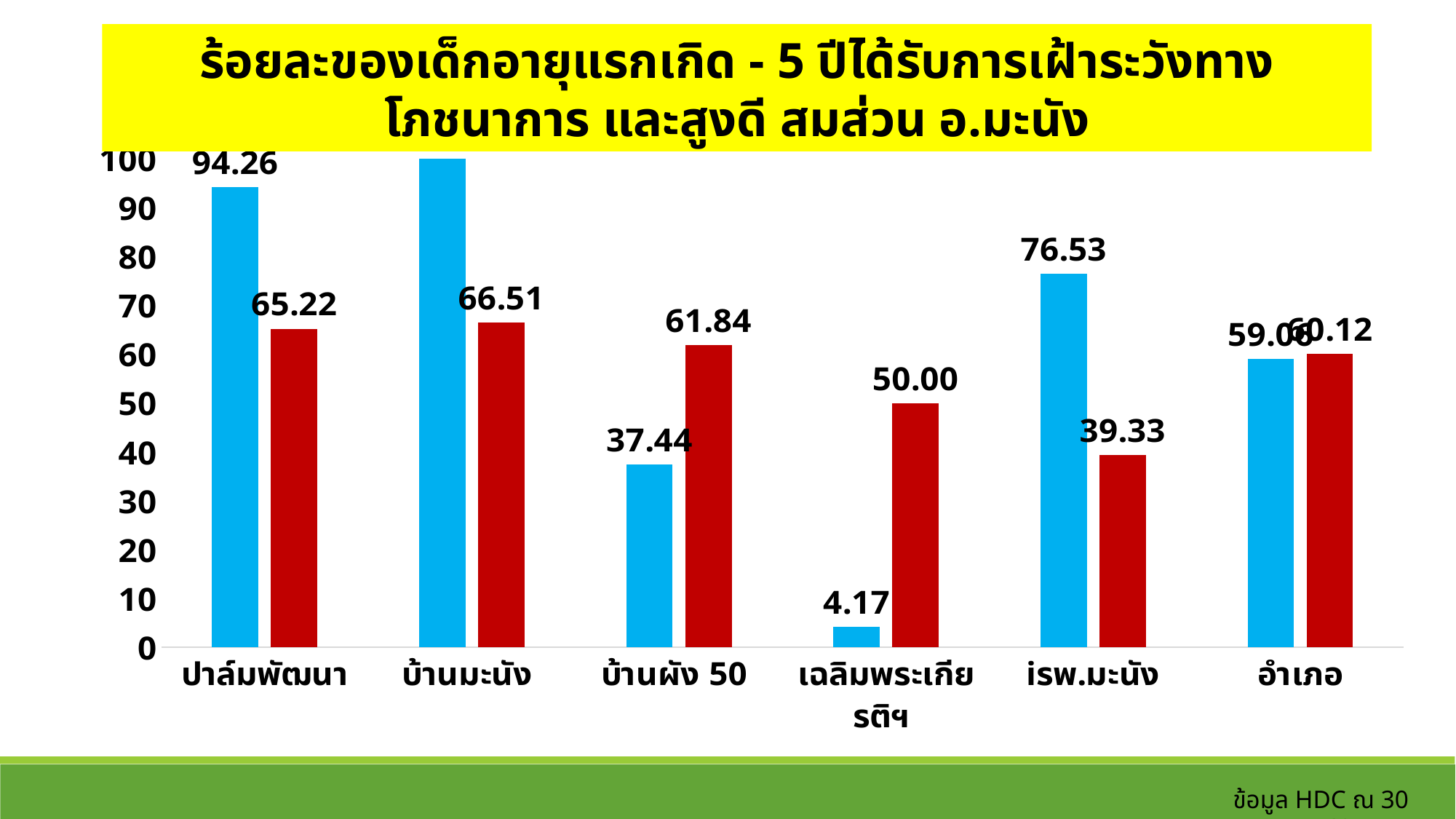
What is the value of the blue bar for ปาล์มพัฒนา? 94.26 What is the value of the red bar for เฉลิมพระเกียรติฯ? 50.00 What kind of chart is shown on the slide? bar chart Is the value of the blue bar for บ้านมะนัง greater or less than 90? greater What is the value of the red bar for บ้านผัง 50? 61.84 What is the difference between the blue bar and the red bar for รพ.มะนัง? 37.20 For บ้านผัง 50, which is larger, the blue bar or the red bar? the red bar Which category has the lowest blue bar? เฉลิมพระเกียรติฯ What is the difference between the blue bar and the red bar for ปาล์มพัฒนา? 29.04 How many categories are shown on the x axis? 6 What is the value of the blue bar for รพ.มะนัง? 76.53 Which category has the lowest red bar? รพ.มะนัง